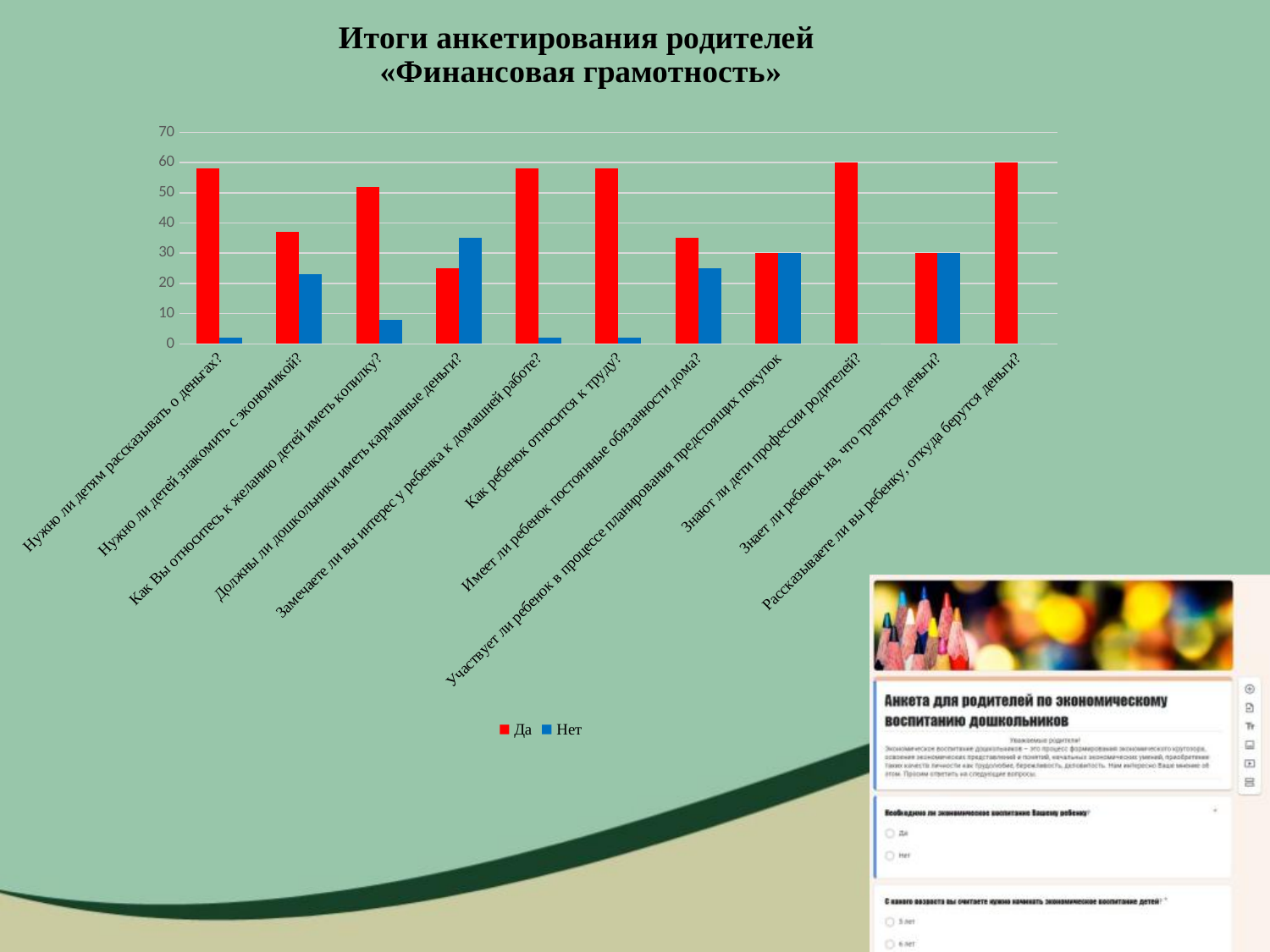
What colour are the bars for the series "Да"? red What are the two entries in the legend? Да and Нет Which category has the lowest "Да" value? Должны ли дошкольники иметь карманные деньги? Is the "Да" value for "Нужно ли детям рассказывать о деньгах?" greater or less than 50? greater Is the "Нет" value for "Нужно ли детей знакомить с экономикой?" greater or less than 30? less What kind of chart is shown on the slide? bar chart Is the "Нет" value for "Должны ли дошкольники иметь карманные деньги?" greater or less than 30? greater How many series does the legend list? 2 How many question categories are plotted along the x axis? 11 For "Как Вы относитесь к желанию детей иметь копилку?", which is larger, "Да" or "Нет"? Да For "Должны ли дошкольники иметь карманные деньги?", which is larger, "Да" or "Нет"? Нет